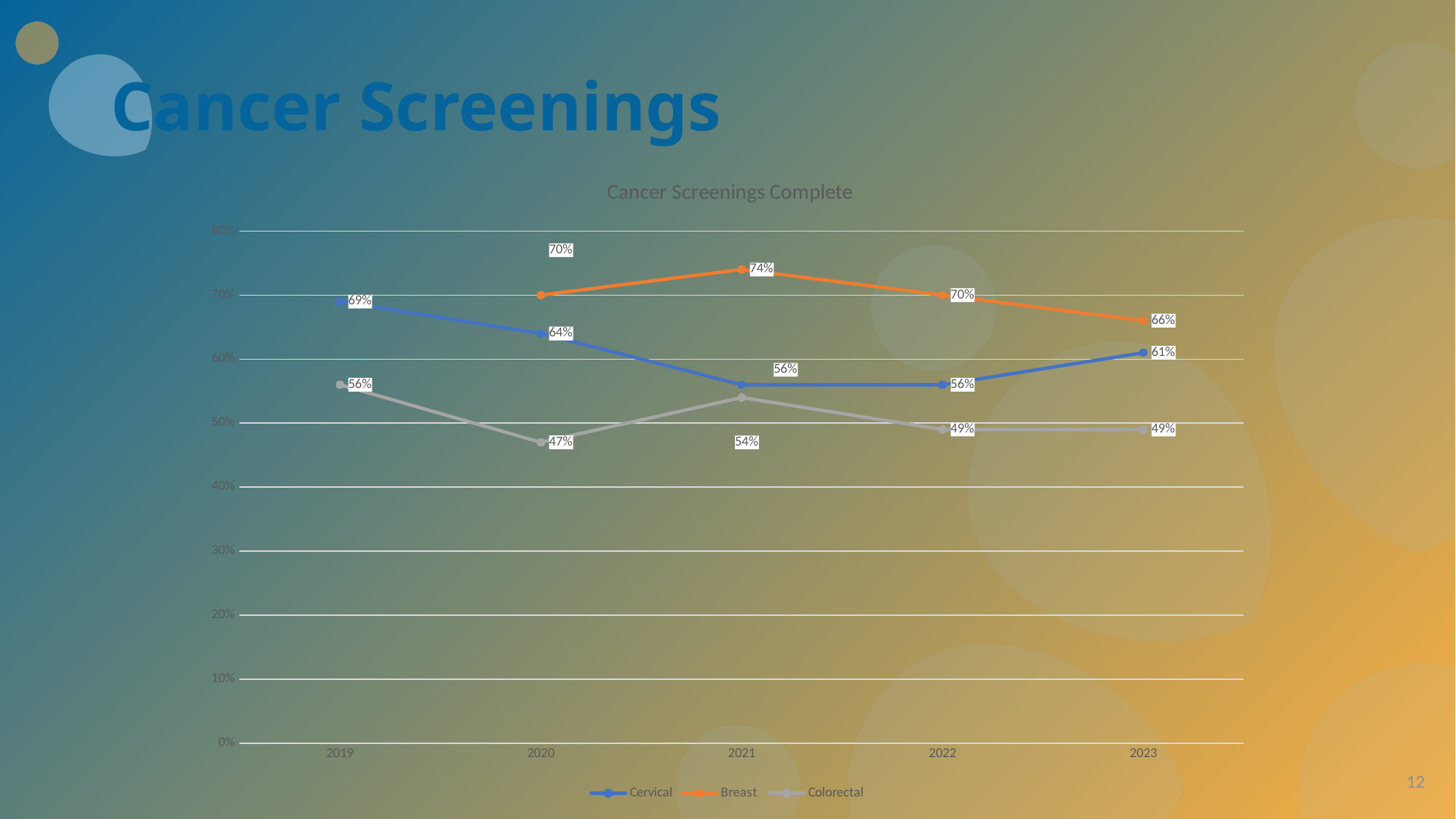
How many years are shown on the x axis? 5 What is the difference between the Cervical values for 2019 and 2023? 8 percentage points What kind of chart is shown on the slide? line chart In which year is the Colorectal screening value lowest? 2020 What is the Cervical screening value for 2019? 69% In which year is the Breast screening value highest? 2021 What is the Cervical screening value for 2023? 61% In 2022, which is larger: the Breast value or the Cervical value? Breast What is the Breast screening value for 2021? 74% What is the Colorectal screening value for 2020? 47% Does the Breast screening value rise or fall from 2021 to 2023? fall How many series does the legend list? 3